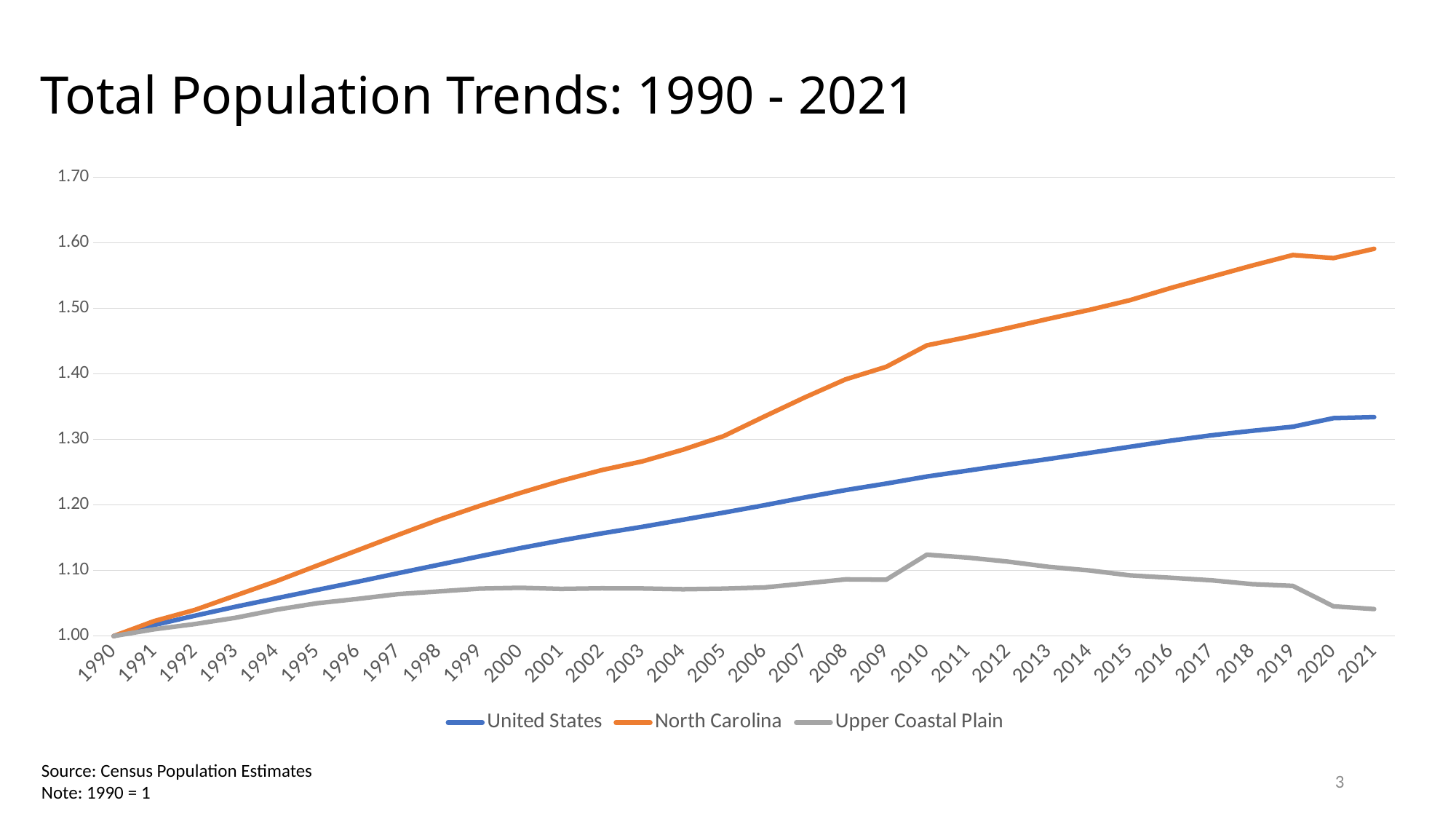
Does the North Carolina line rise or fall from 1990 to 2021? rise Which series has the highest value in 2021? North Carolina Is the value for North Carolina in 2021 greater or less than 1.50? greater Is the value for United States in 2021 greater or less than 1.40? less Is the value for Upper Coastal Plain in 2021 greater or less than 1.10? less In 2021, which is higher: North Carolina or United States? North Carolina Which series has the lowest value in 2021? Upper Coastal Plain How many years are shown along the x axis? 32 What colour is the North Carolina line? orange What type of chart is shown on the slide? line chart What is the value for North Carolina in 1990? 1.00 How many series does the legend list? 3